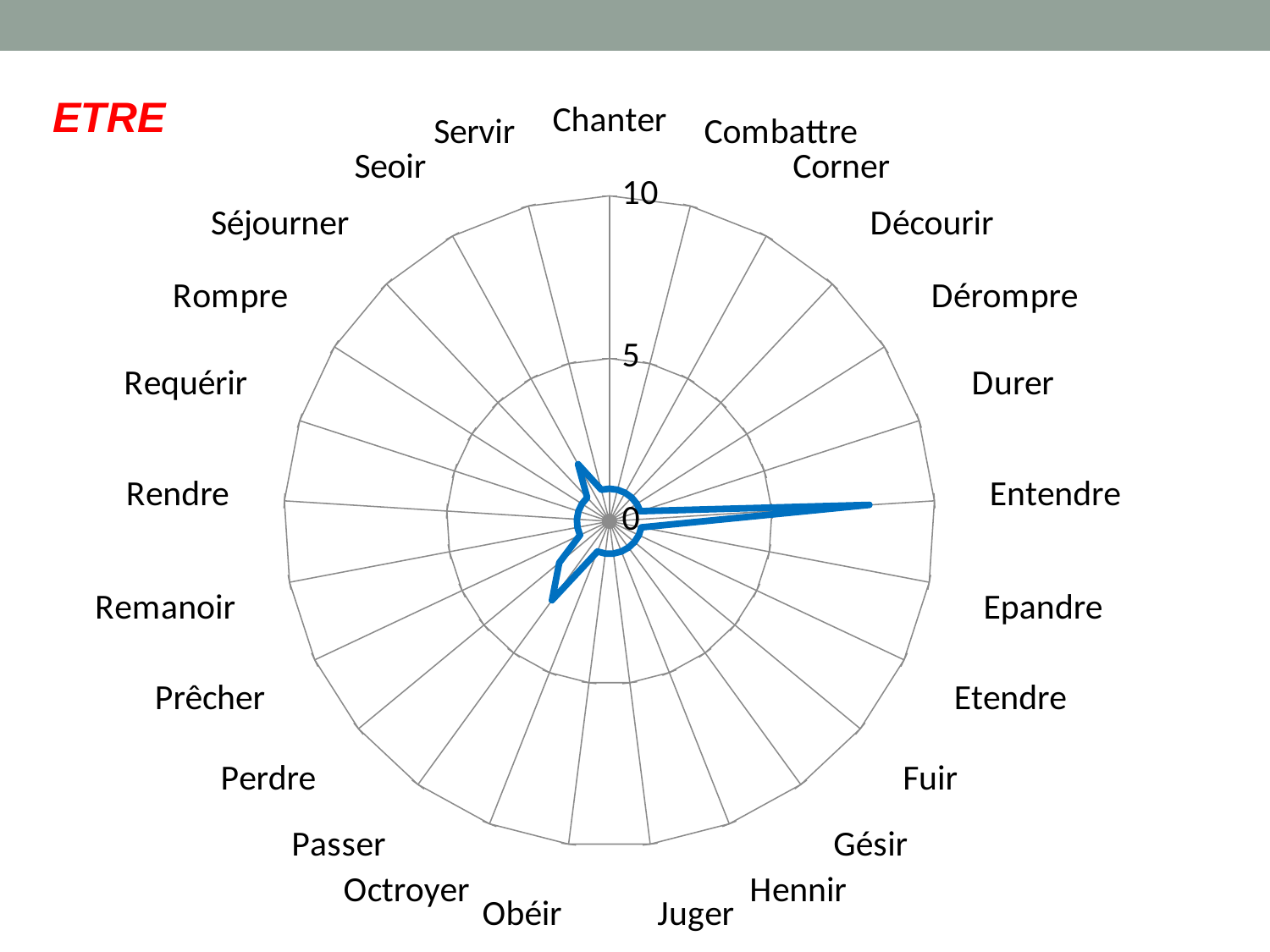
What is the title shown in red at the top left of the slide? ETRE How many categories are plotted around the radar chart? 25 Which has the larger value, Entendre or Rendre? Entendre Is the value for Durer greater or less than 5? less Is the value for Octroyer greater or less than 5? less Which has the larger value, Entendre or Durer? Entendre What is the maximum value labelled on the radar chart's axis? 10 Is the value for Entendre greater or less than 5? greater Which category has the highest value on the radar chart? Entendre What kind of chart is shown on the slide? Radar chart